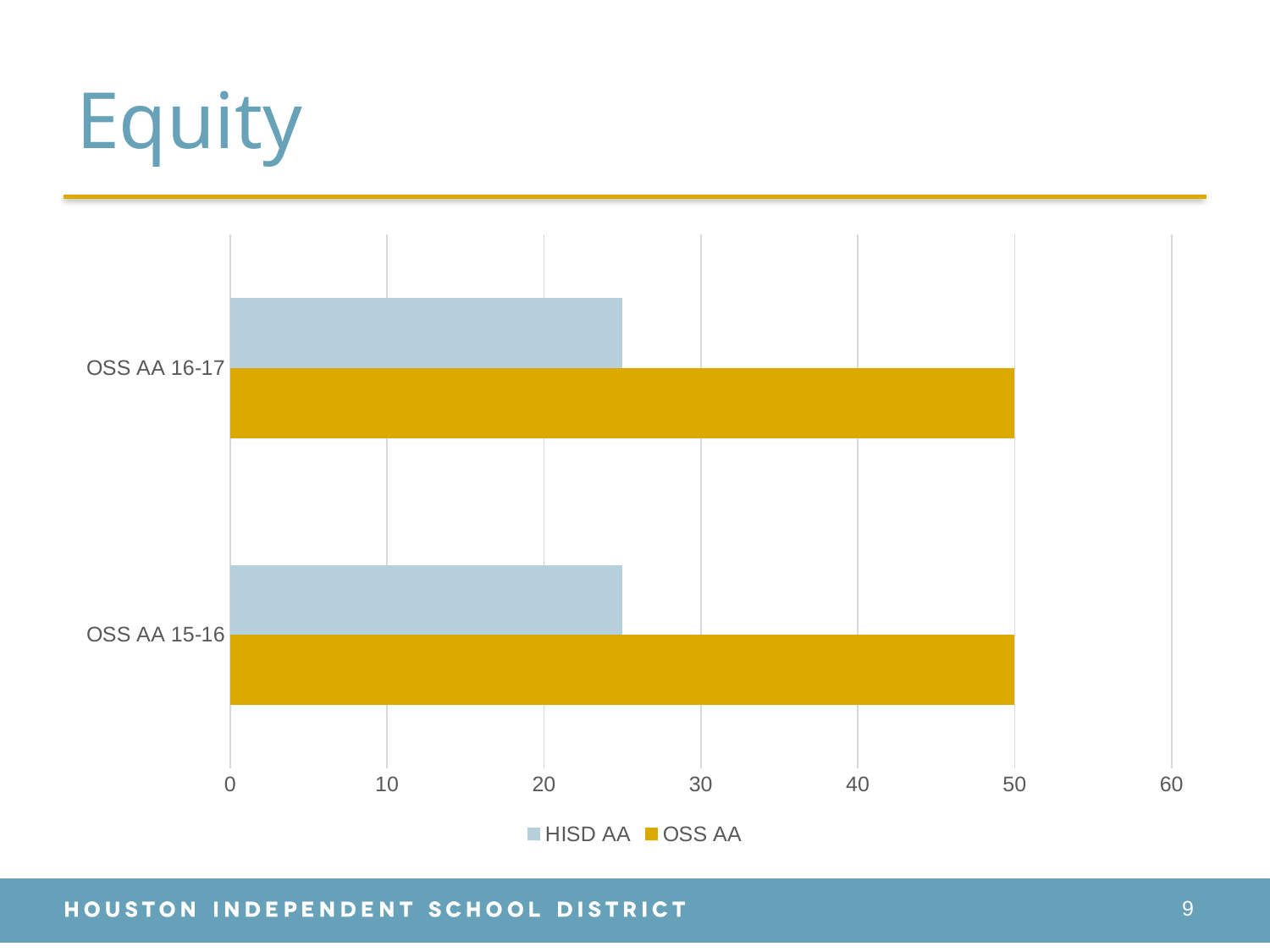
What is the OSS AA value for OSS AA 16-17? 50 What are the two entries in the chart legend? HISD AA and OSS AA What kind of chart is shown on the slide? bar chart Which series has the longest bar in the chart? OSS AA Does the OSS AA value rise, fall, or stay the same from OSS AA 15-16 to OSS AA 16-17? stays the same What is the OSS AA value for OSS AA 15-16? 50 Is the HISD AA value for OSS AA 15-16 greater or less than 20? greater Is the HISD AA value for OSS AA 16-17 greater or less than 30? less How many series does the legend list? 2 For OSS AA 15-16, which series has the larger value, HISD AA or OSS AA? OSS AA How many categories are shown on the vertical axis? 2 For OSS AA 16-17, which series has the larger value, HISD AA or OSS AA? OSS AA